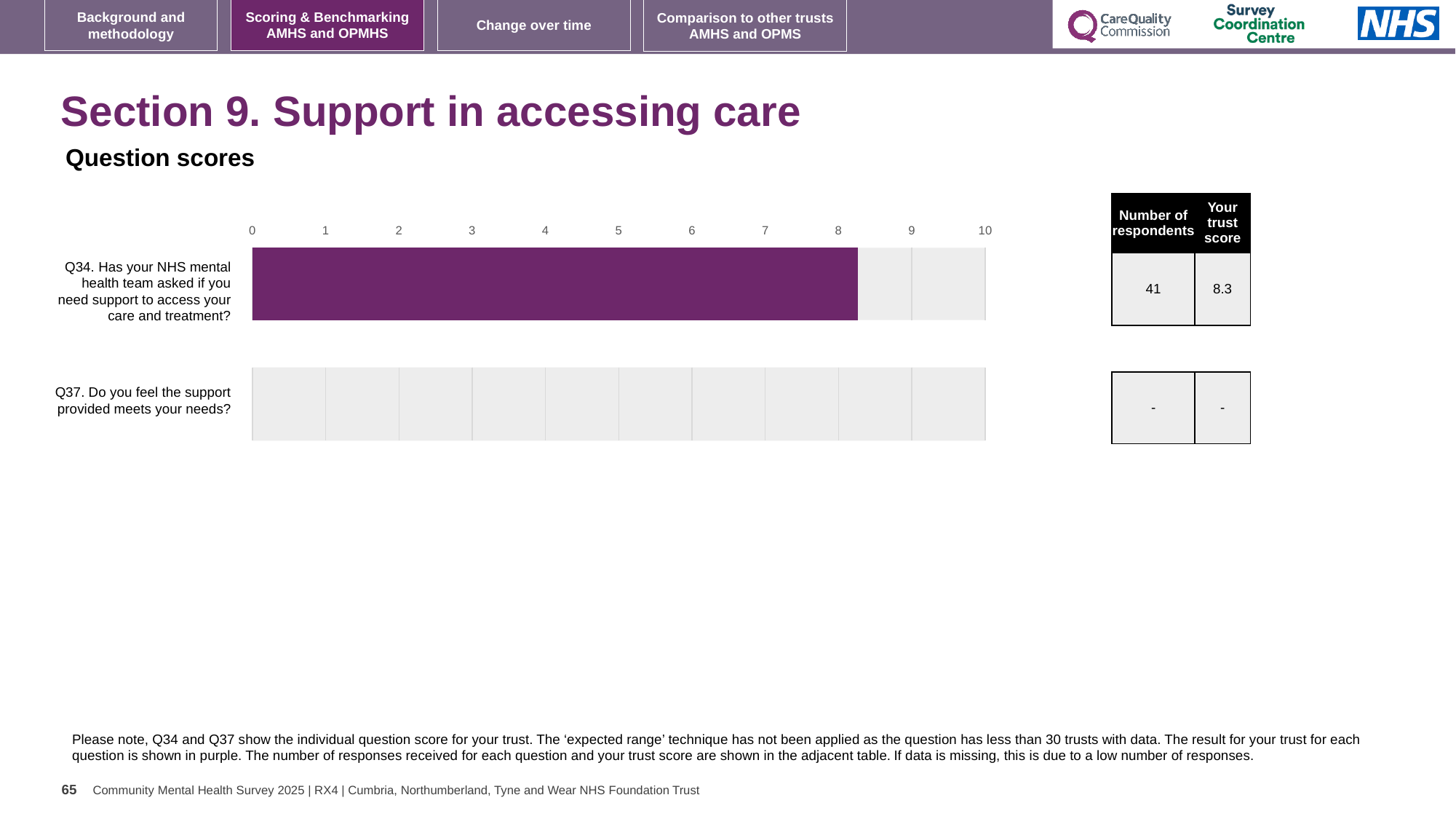
What is the maximum value shown on the chart's axis? 10 How many respondents answered Q34? 41 What is shown as the trust score for Q37 (Do you feel the support provided meets your needs?)? - What kind of chart is shown on the slide? Bar chart Which question has a bar plotted on the chart? Q34 How many questions are plotted on the chart? 2 What is the trust score for Q34 (Has your NHS mental health team asked if you need support to access your care and treatment?)? 8.3 Is the score for Q34 greater or less than 9? less What colour is the bar for Q34? Purple Is the score for Q34 greater or less than 8? greater